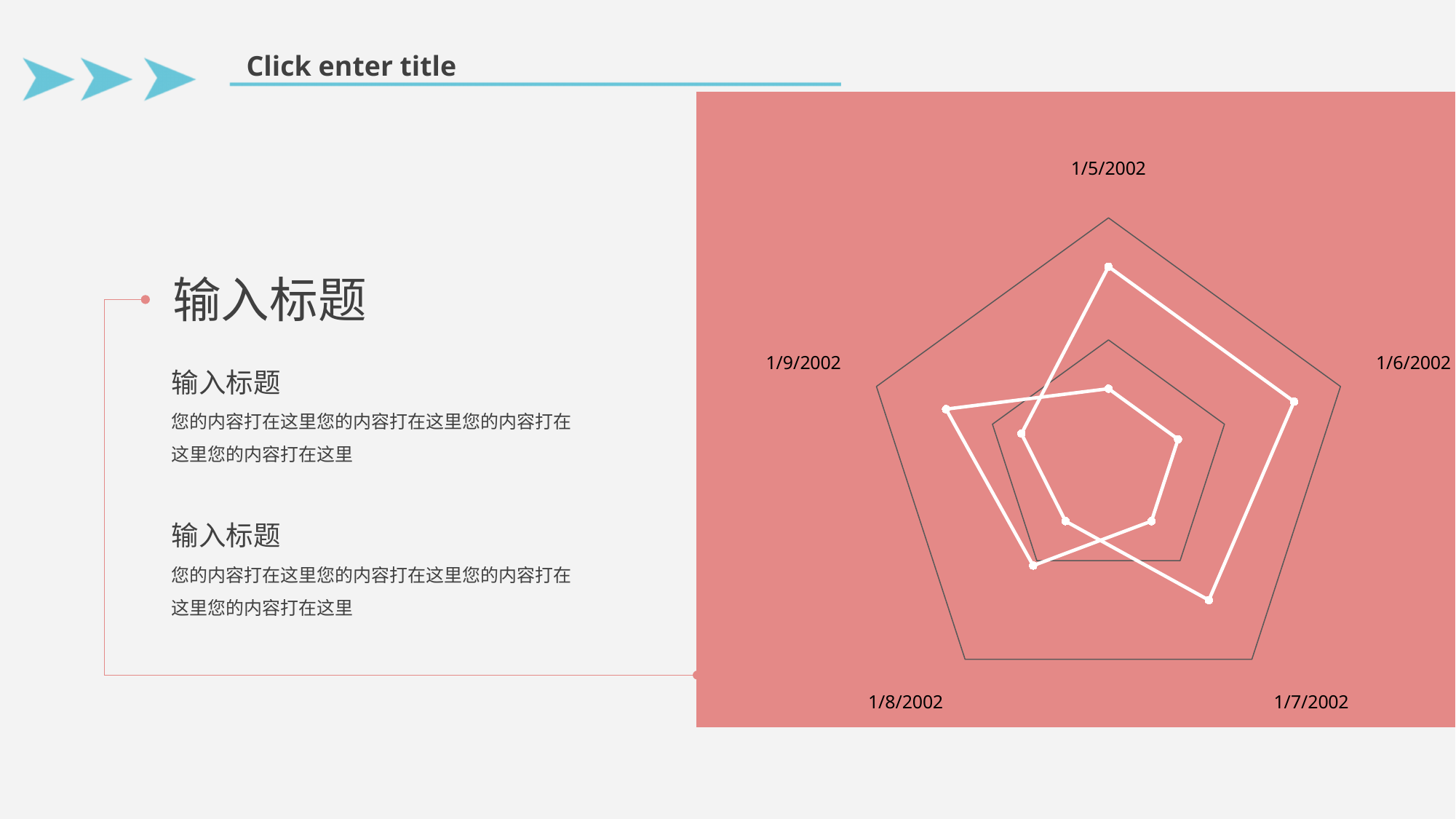
For the larger white polygon, is the value for 1/5/2002 or 1/8/2002 larger? 1/5/2002 For the larger white polygon, which category has the lowest value? 1/8/2002 Which category label appears at the top of the radar chart? 1/5/2002 For the larger white polygon, is the value for 1/6/2002 or 1/8/2002 larger? 1/6/2002 What kind of chart is shown on the slide? radar chart Which category label appears at the bottom right of the radar chart? 1/7/2002 How many data series are plotted on the radar chart? 2 How many categories (axes) does the radar chart have? 5